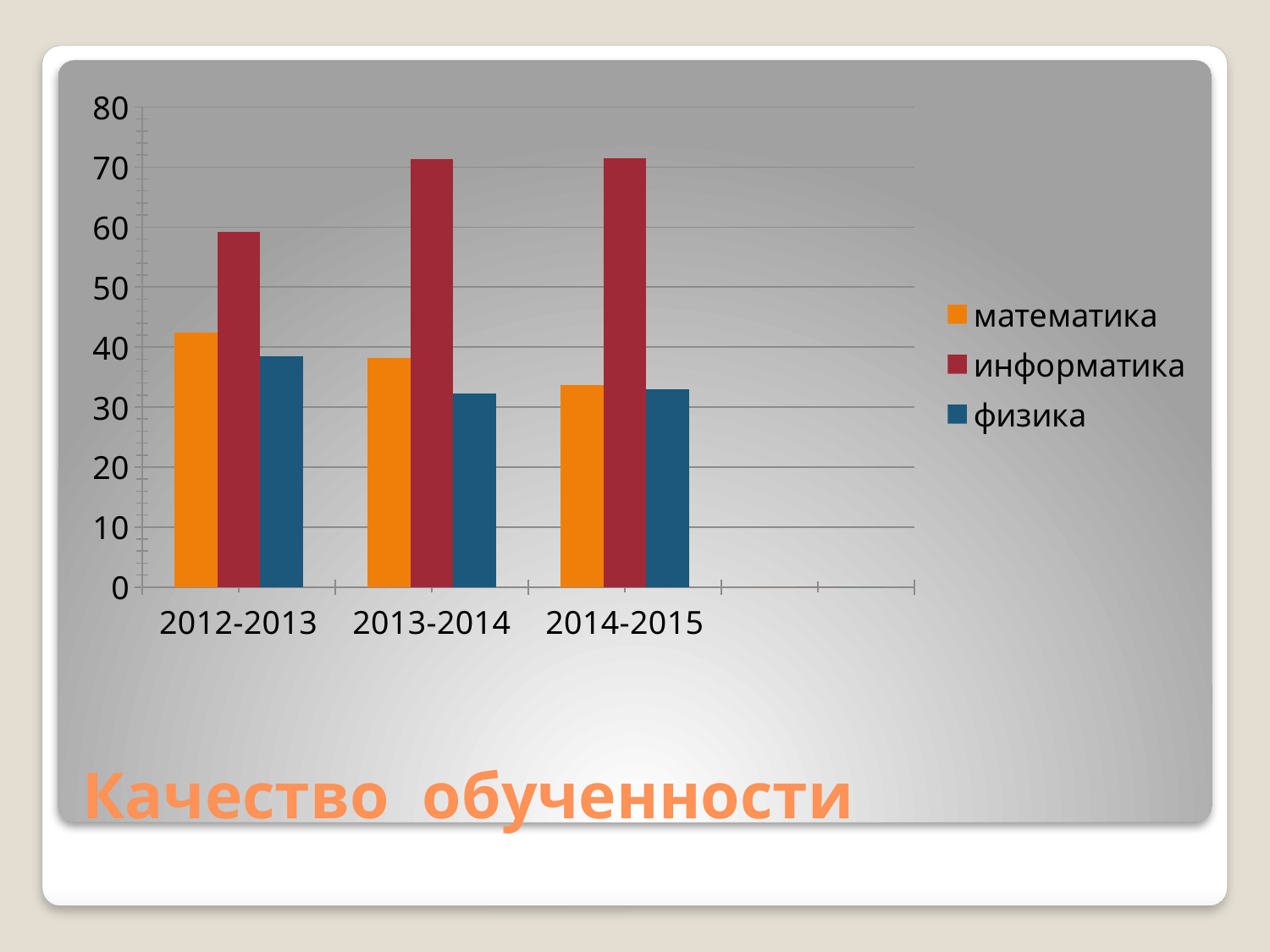
Is the value for физика in 2013-2014 greater or less than 40? less Does the value for математика rise or fall from 2012-2013 to 2014-2015? fall Is the value for математика in 2012-2013 greater or less than 50? less In 2012-2013, which is larger: математика or физика? математика How many academic-year categories are shown on the x axis? 3 Is the value for информатика in 2012-2013 greater or less than 50? greater Which series has the highest value in 2014-2015? информатика What is the title of the chart? Качество обученности Which series is shown in orange in the legend? математика How many series does the legend list? 3 What kind of chart is shown on the slide? bar chart